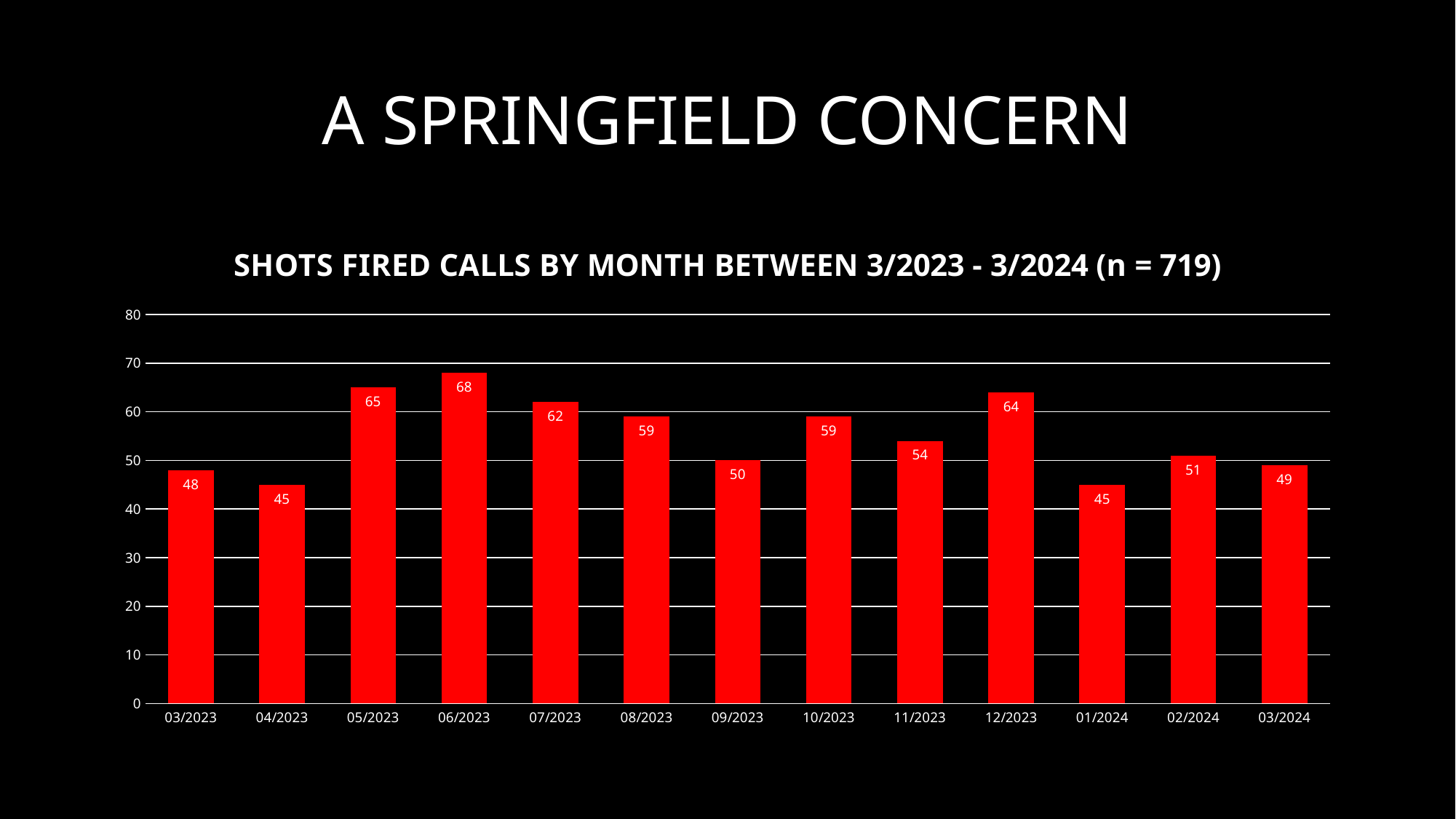
What is the value for 12/2023? 64 Which month has the highest number of shots fired calls? 06/2023 What is the difference between the values for 06/2023 and 04/2023? 23 What is the title of the chart? SHOTS FIRED CALLS BY MONTH BETWEEN 3/2023 - 3/2024 (n = 719) Is the value for 07/2023 greater or less than 60? greater What is the value for 06/2023? 68 What colour are the bars in the chart? red What kind of chart is shown on the slide? bar chart Which is larger, the value for 05/2023 or the value for 11/2023? 05/2023 What is the value for 09/2023? 50 Do the values rise or fall from 12/2023 to 01/2024? fall How many months are shown on the x axis? 13